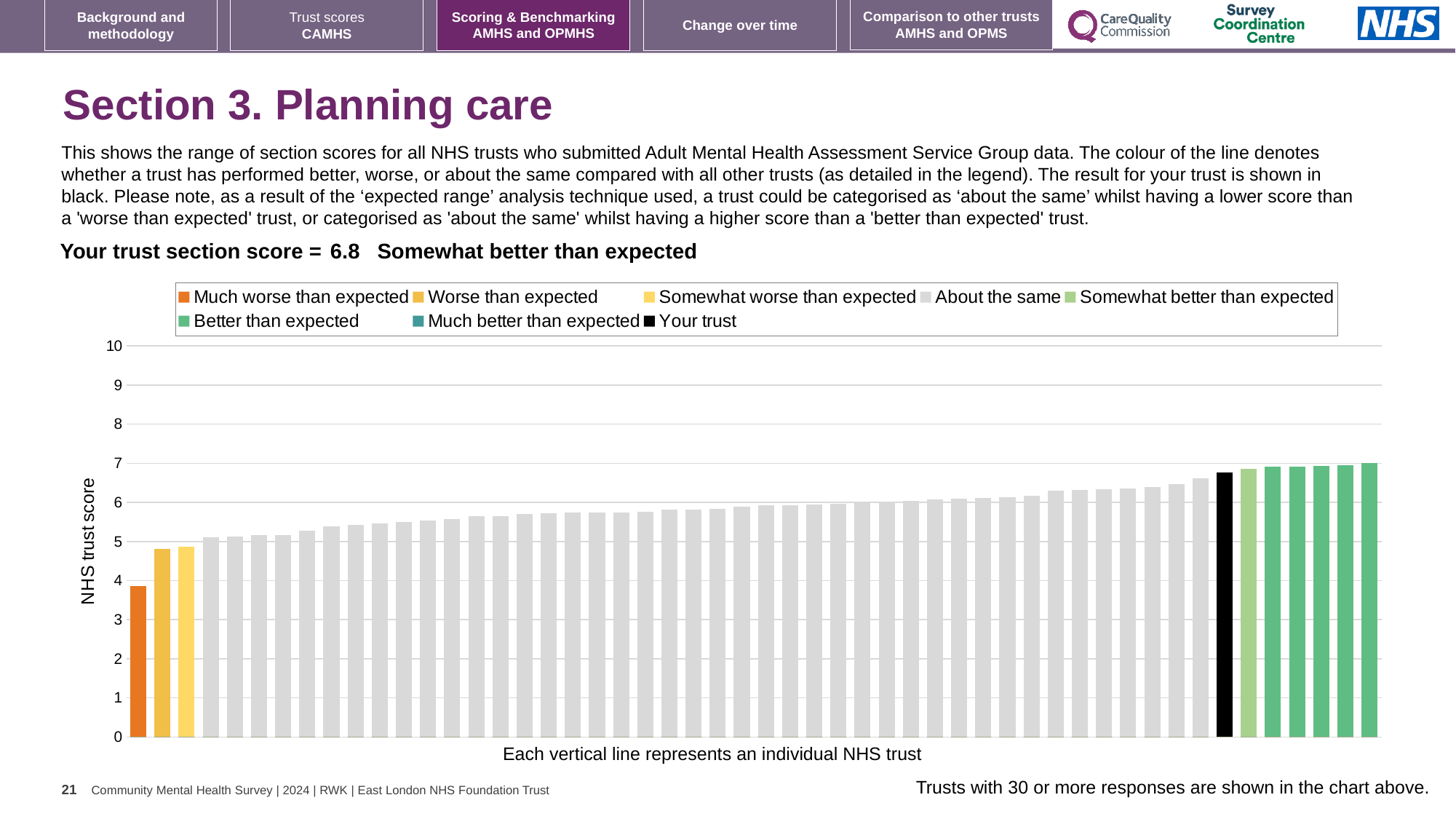
Is the value for the 'Much worse than expected' trust greater or less than 5? less What is the section score for your trust shown on the slide? 6.8 Is the value for your trust greater or less than 6? greater What is the label on the vertical axis of the chart? NHS trust score Which legend category does the highest bar belong to? Better than expected What kind of chart is shown on the slide? bar chart How many bars are coloured as 'Worse than expected'? 1 Do the bar values rise or fall from left to right along the x axis? rise Which legend category does the lowest bar belong to? Much worse than expected Which category is your trust placed in according to the slide? Somewhat better than expected How many entries does the chart legend list? 8 How many bars are coloured as 'Better than expected'? 5